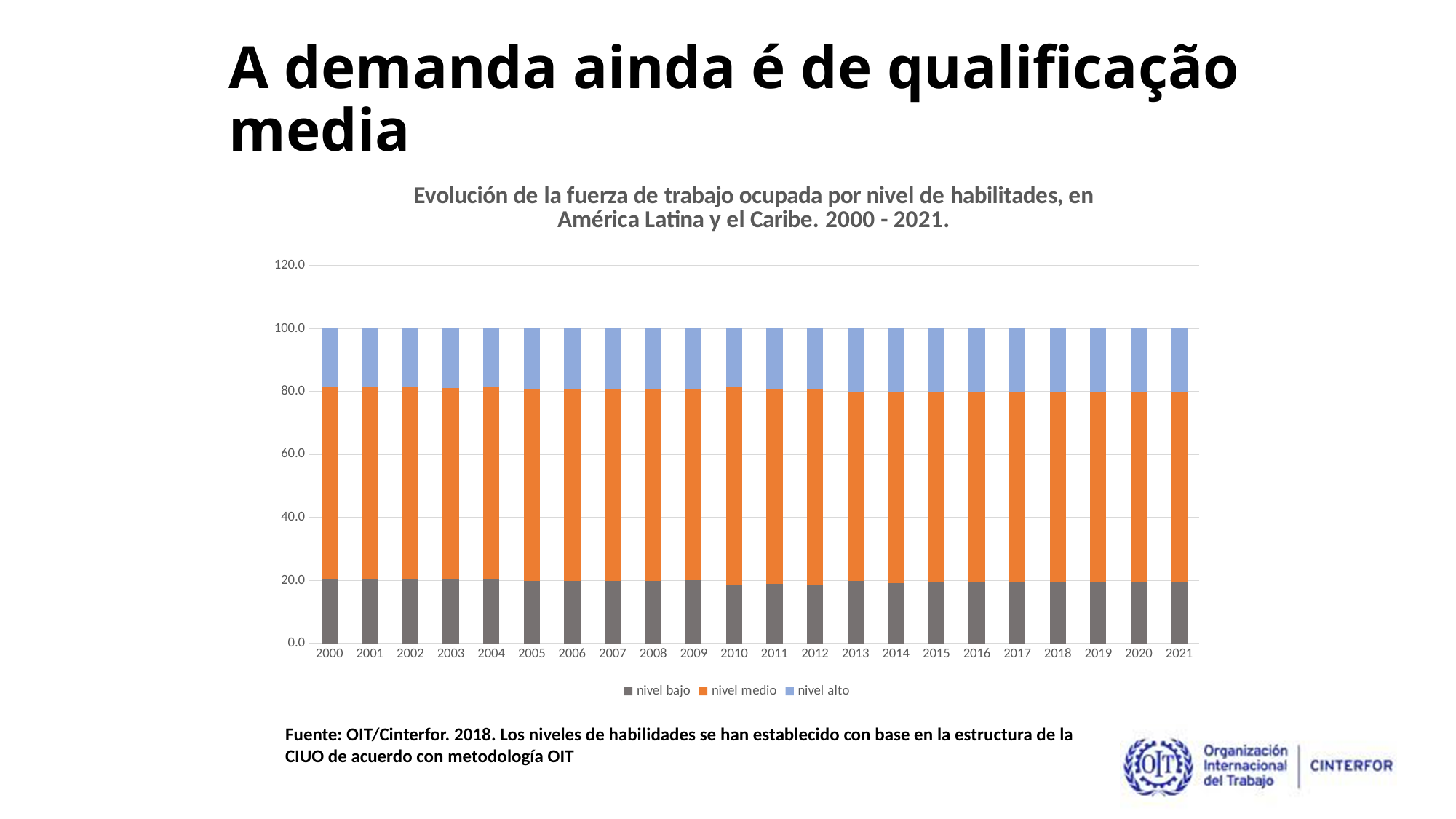
How many years are shown along the x axis? 22 Is the nivel alto segment for 2005 greater or less than 40? less What is the total height of the stacked bar for 2021? 100.0 In 2021, which is larger: the nivel medio segment or the nivel alto segment? nivel medio Which series is shown in orange? nivel medio What is the first year shown on the x axis? 2000 What kind of chart is shown on the slide? stacked bar chart What is the total height of the stacked bar for 2000? 100.0 Is the nivel medio segment for 2010 greater or less than 40? greater How many series does the legend list? 3 Which series occupies the largest portion of each bar? nivel medio Is the nivel bajo segment for 2015 greater or less than 40? less